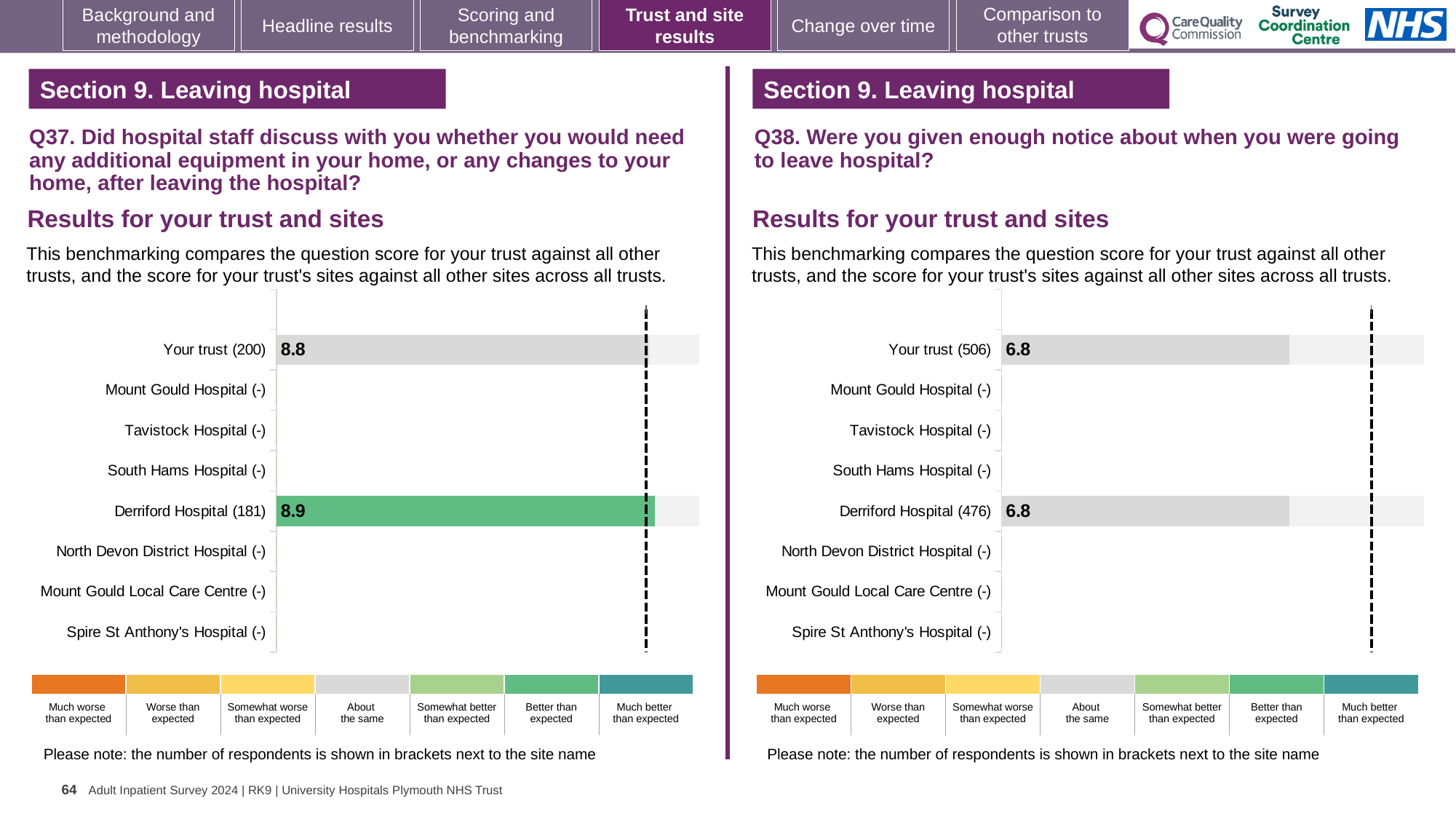
In the Q37 chart on the left, what is the difference between the Derriford Hospital score and the Your trust score? 0.1 What type of chart is used for the Q38 results on the right? Bar chart In the Q37 chart on the left, what colour is the Derriford Hospital bar? Green In the Q37 chart on the left, which has the higher score, Your trust or Derriford Hospital? Derriford Hospital In the Q38 chart on the right, how many respondents are shown in brackets for Your trust? 506 How many site or trust categories are listed on the y axis of the Q37 chart on the left? 8 In the Q38 chart on the right, what is the score for Your trust? 6.8 In the Q38 chart on the right, what is the score for Derriford Hospital? 6.8 In the Q37 chart on the left, how many respondents are shown in brackets for Derriford Hospital? 181 In the Q37 chart on the left, what is the score for Your trust? 8.8 In the Q38 chart on the right, what is the difference between the Your trust score and the Derriford Hospital score? 0 In the Q37 chart on the left, what is the score for Derriford Hospital? 8.9